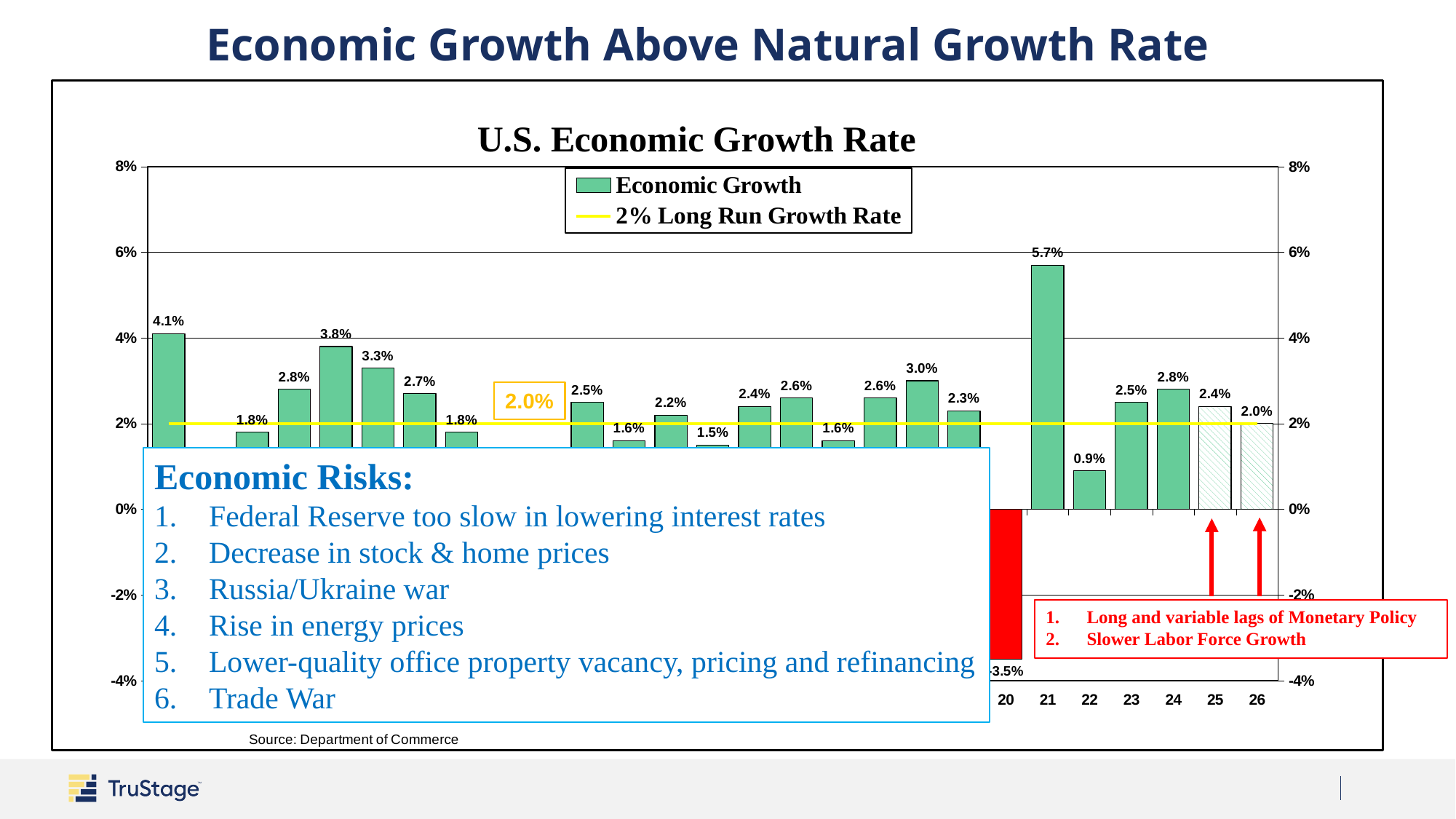
What is the economic growth rate for 24? 2.8% How many series does the legend list? 2 What is the economic growth rate for 21? 5.7% Is the economic growth rate for 22 greater or less than 2%? less Which year has a higher economic growth rate, 23 or 24? 24 What is the economic growth rate for 26? 2.0% Which year has the lowest economic growth rate? 20 Which year has the highest economic growth rate? 21 What is the difference between the economic growth rate for 21 and for 22? 4.8% What type of chart is used to show Economic Growth? bar chart What is the economic growth rate for 22? 0.9% What is the title of the chart? U.S. Economic Growth Rate